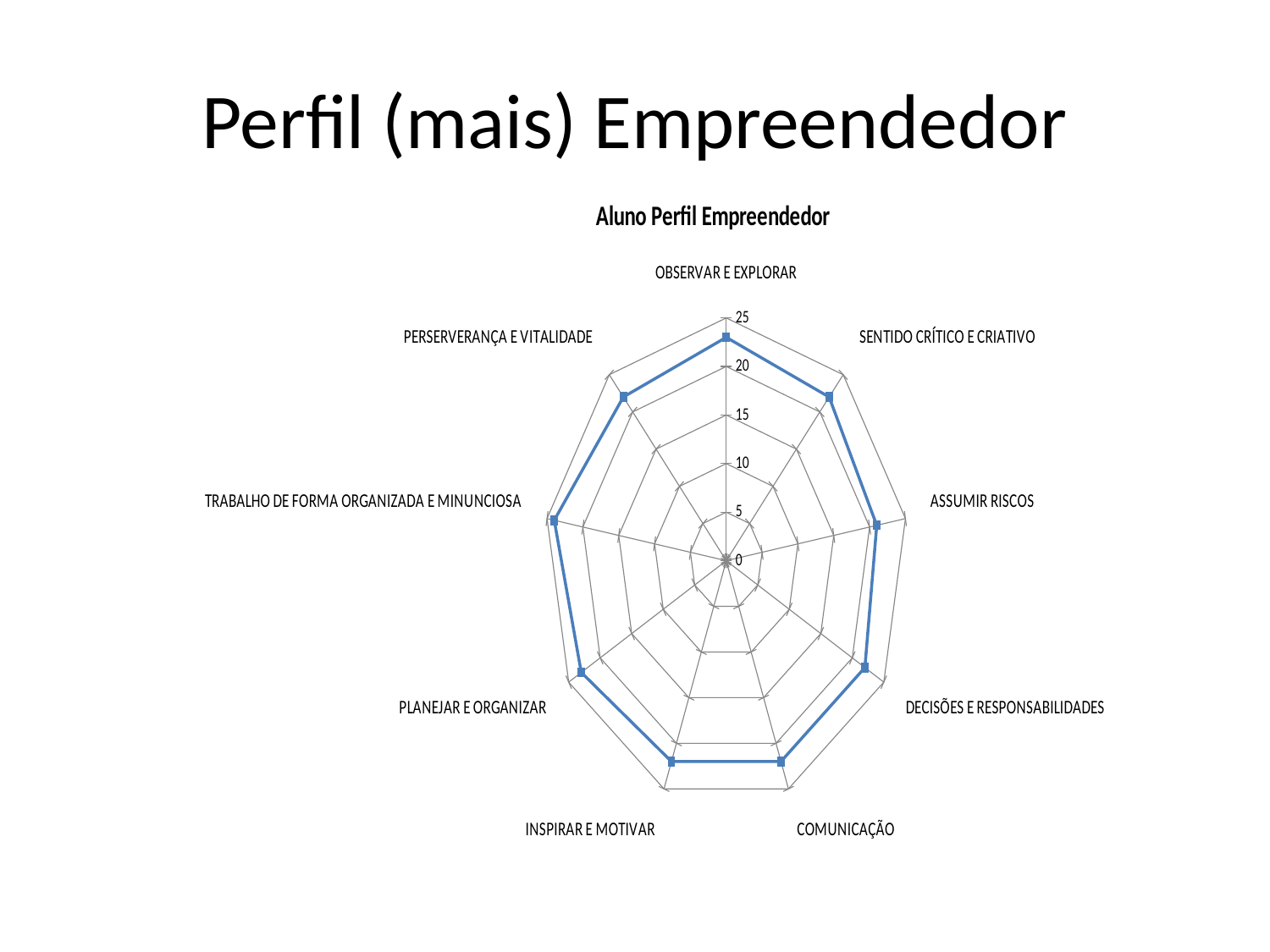
Is the value for PERSERVERANÇA E VITALIDADE greater or less than 25? less Is the value for DECISÕES E RESPONSABILIDADES greater or less than 20? greater What is the title of the chart? Aluno Perfil Empreendedor Is the value for COMUNICAÇÃO greater or less than 15? greater How many categories (axes) does the radar chart have? 9 What kind of chart is shown on the slide? radar chart What is the highest value shown on the chart's axis scale? 25